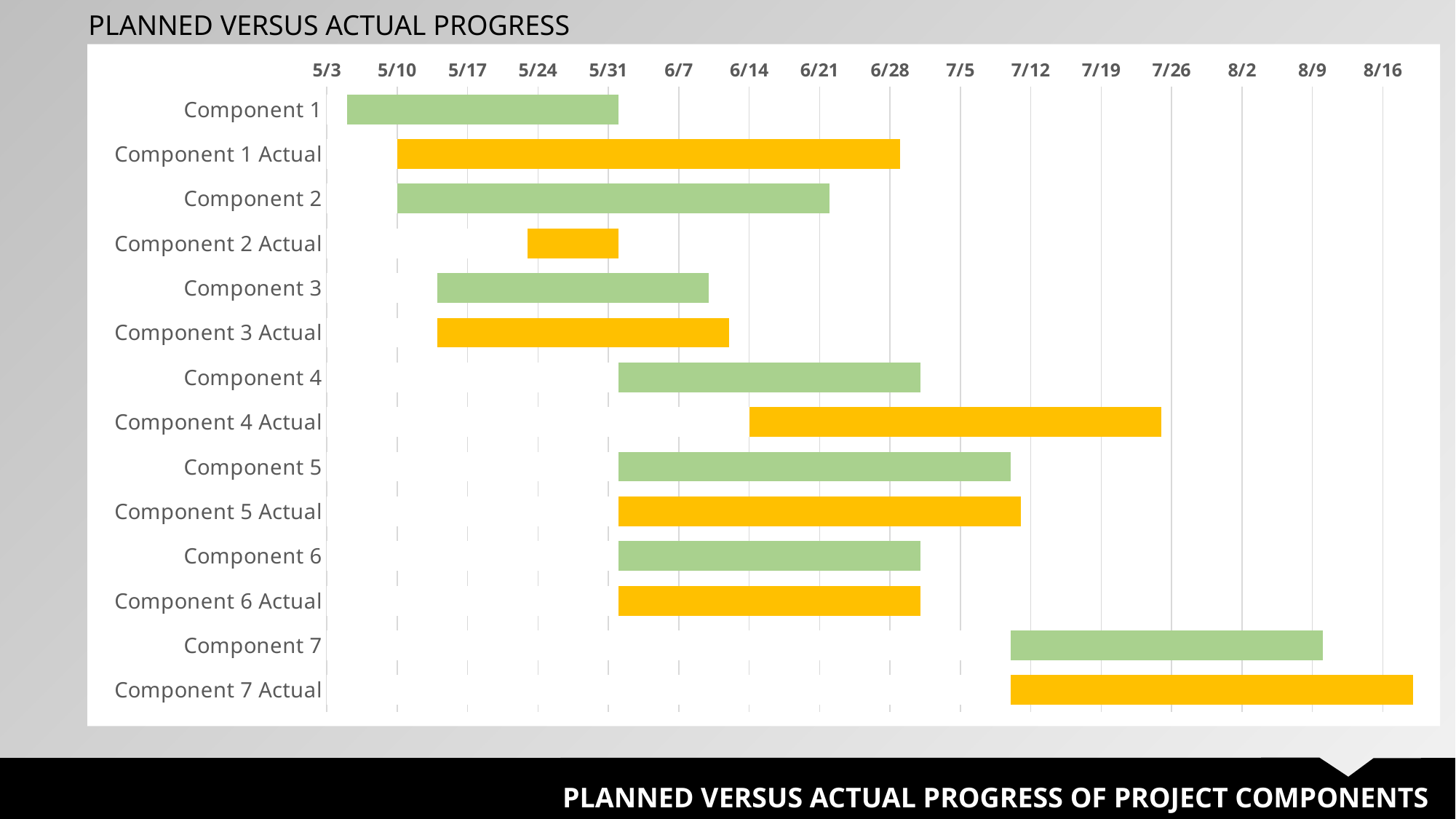
Which bar is longer, Component 2 or Component 2 Actual? Component 2 Which bar is longer, Component 1 or Component 1 Actual? Component 1 Actual Which row's bar starts earliest on the timeline? Component 1 Which row has the shortest bar in the chart? Component 2 Actual Does the Component 2 Actual bar end earlier or later than 6/7? earlier How many bars (rows) are plotted in the chart? 14 On which date tick does the Component 4 Actual bar start? 6/14 What colour are the 'Actual' bars in the chart? Yellow/orange What kind of chart is shown on the slide? Bar chart (Gantt chart) What is the title shown above the chart? PLANNED VERSUS ACTUAL PROGRESS Which row's bar ends latest on the timeline? Component 7 Actual Does the Component 7 Actual bar end earlier or later than 8/16? later